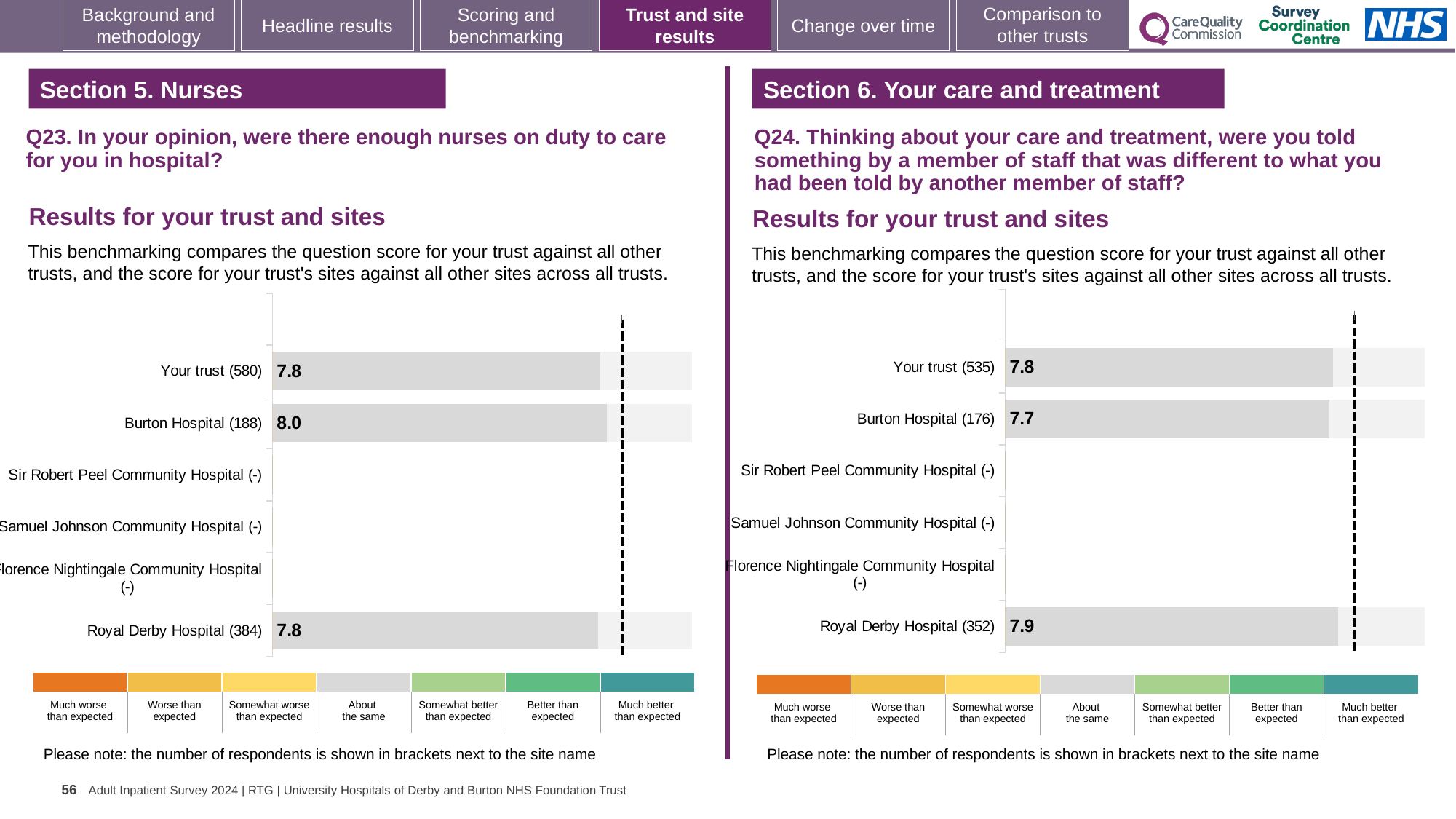
In the Q24 chart on the right, what is the difference between the Royal Derby Hospital score and the Your trust score? 0.1 In the Q23 chart on the left, what is the score for Your trust (580)? 7.8 In the Q23 chart on the left, what is the difference between the Burton Hospital score and the Royal Derby Hospital score? 0.2 In the Q23 chart on the left, which site has the highest score? Burton Hospital (188) In the Q24 chart on the right, what is the score for Royal Derby Hospital (352)? 7.9 How many sites in the Q23 chart on the left have a score shown? 3 In the Q23 chart on the left, what is the score for Burton Hospital (188)? 8.0 What type of chart is used for the Q24 results on the right? Bar chart How many categories does the colour key below the Q23 chart on the left list? 7 In the Q24 chart on the right, what is the score for Burton Hospital (176)? 7.7 In the Q24 chart on the right, which site has the lowest score? Burton Hospital (176) In the Q24 chart on the right, which is larger: the score for Royal Derby Hospital or the score for Burton Hospital? Royal Derby Hospital